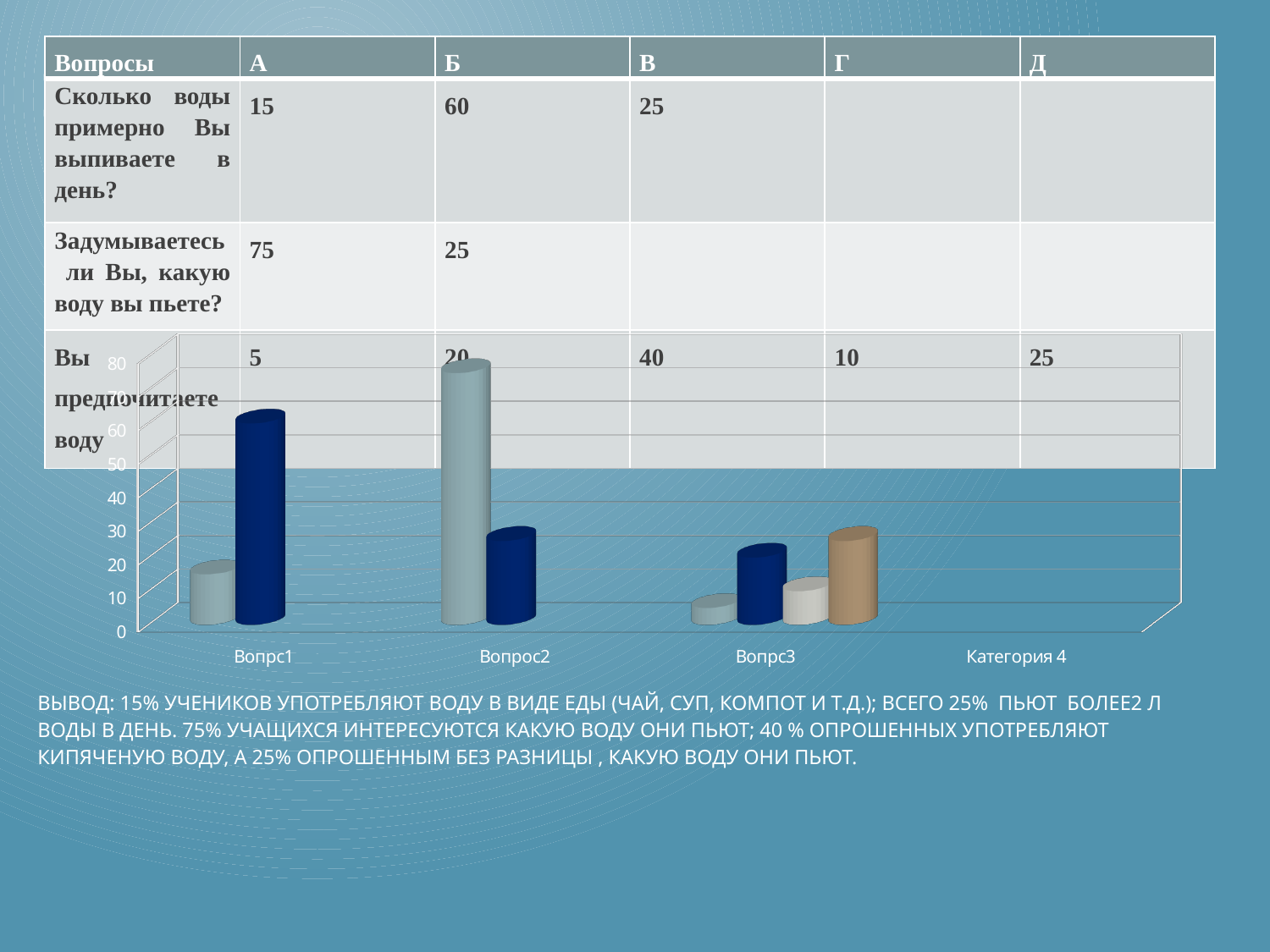
Is the value of the brown bar for Вопрс3 greater or less than 40? less Which category on the x axis contains the tallest bar in the chart? Вопрос2 What kind of chart is shown on the slide? bar chart For Вопрс1, which bar is taller: the dark blue bar or the light grey bar? the dark blue bar Is the value of the dark blue bar for Вопрос2 greater or less than 40? less Is the value of the light grey bar for Вопрс1 greater or less than 30? less For Вопрос2, which bar is taller: the light grey bar or the dark blue bar? the light grey bar What is the highest tick value shown on the vertical axis of the chart? 80 What is the label of the fourth category on the x axis of the chart? Категория 4 How many categories are labelled on the x axis of the chart? 4